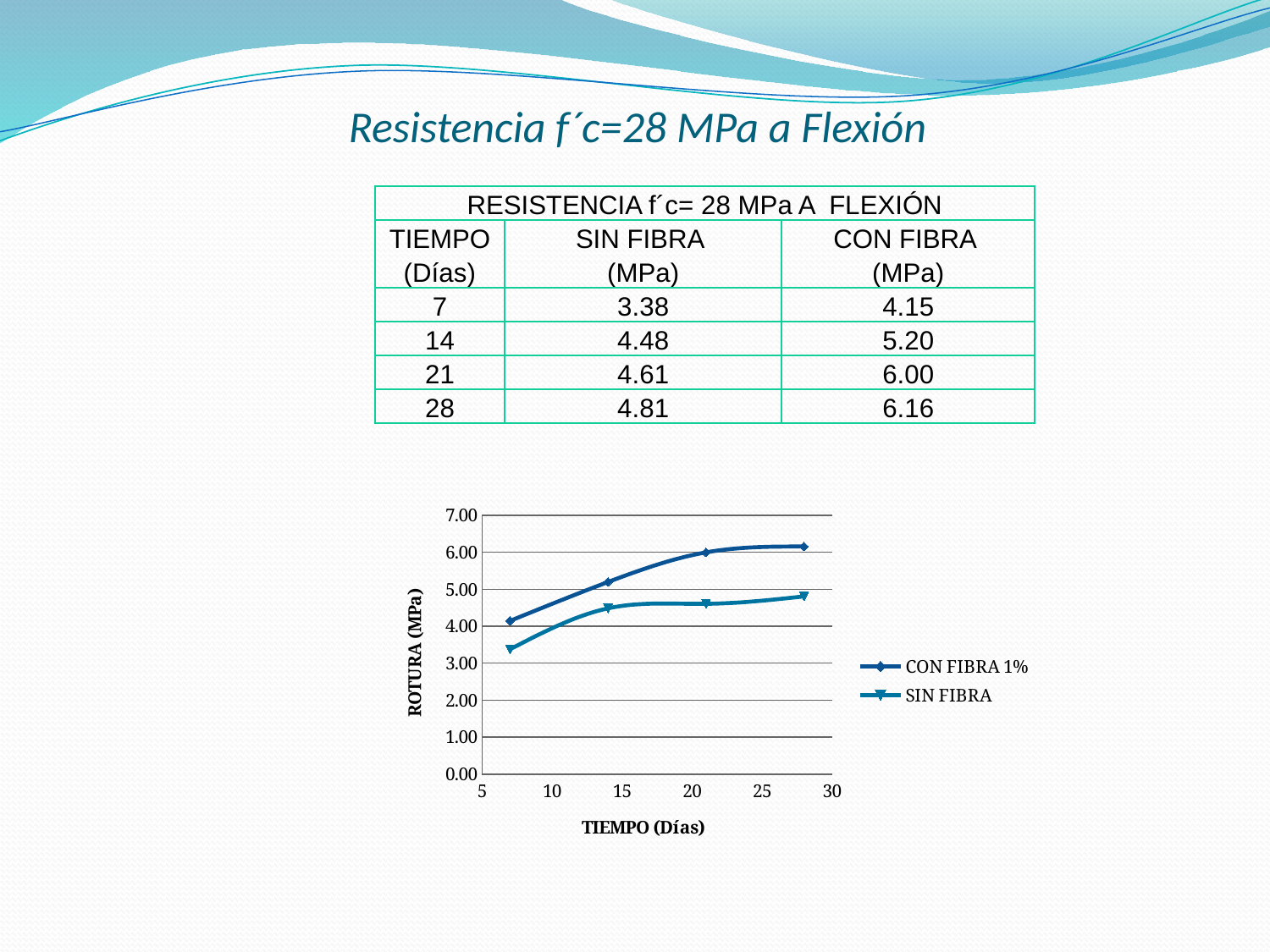
How many series does the chart legend list? 2 Is the value for SIN FIBRA at 7 days greater or less than 4.00 on the chart? less What type of chart is shown on the slide? line chart What is the value for CON FIBRA at 28 days, as printed in the table? 6.16 How many data points are plotted for the SIN FIBRA series? 4 What is the difference between the CON FIBRA and SIN FIBRA values at 21 days? 1.39 Do the values of the SIN FIBRA series rise or fall as time increases along the x axis? rise What are the two series named in the chart legend? CON FIBRA 1% and SIN FIBRA Is the value for CON FIBRA 1% at 28 days greater or less than 6.00 on the chart? greater What is the value for SIN FIBRA at 7 days, as printed in the table? 3.38 What is the label of the chart's y axis? ROTURA (MPa) Which series has the higher value at 14 days, CON FIBRA 1% or SIN FIBRA? CON FIBRA 1%